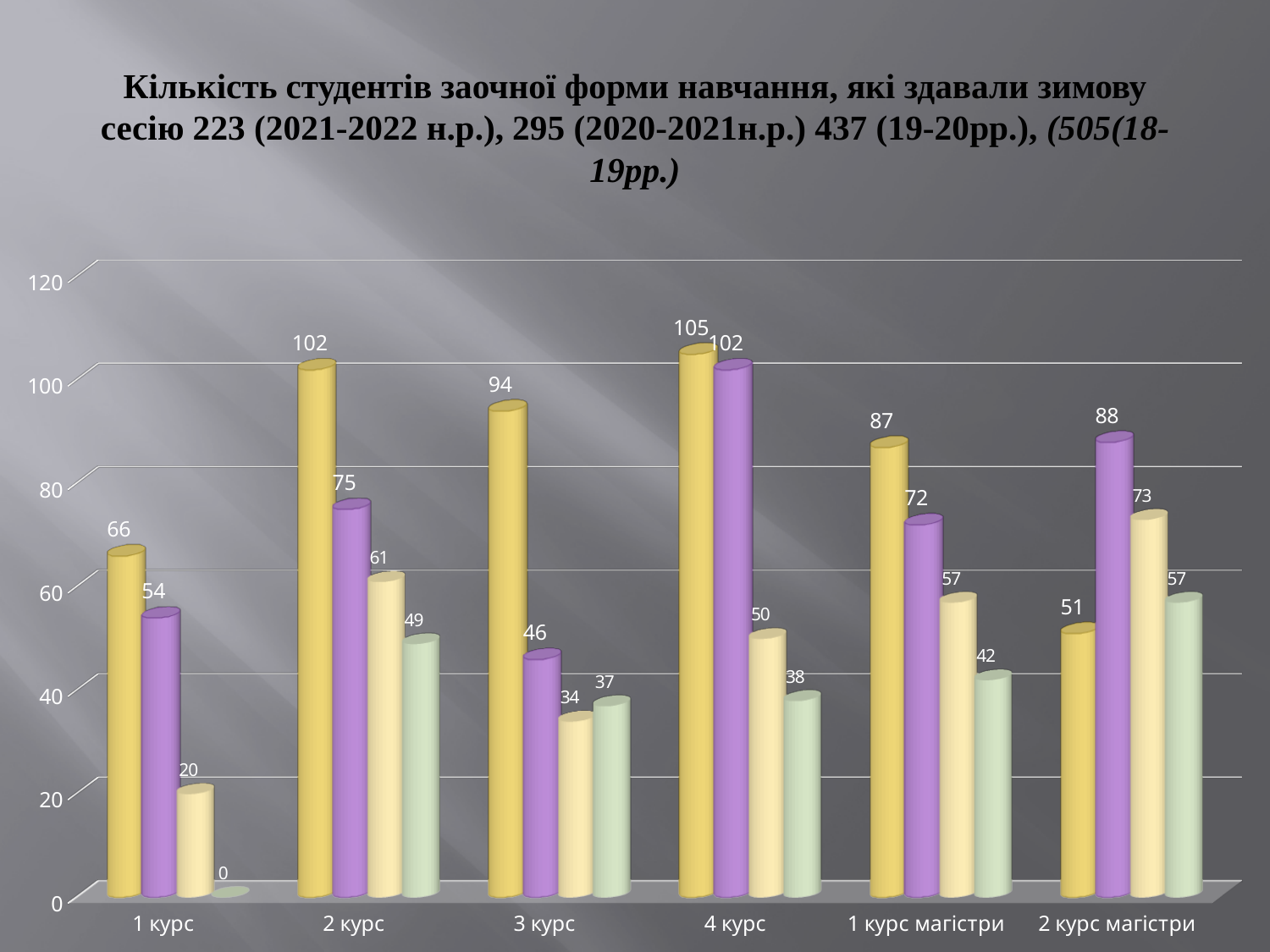
What is the difference between the gold bar and the purple bar for 2 курс? 27 What is the difference between the purple bar and the pale green bar for 1 курс магістри? 30 What is the value of the pale green (fourth) bar for 1 курс? 0 What is the value of the pale yellow (third) bar for 3 курс? 34 Which category has the highest gold (first) bar? 4 курс For 2 курс магістри, which is larger: the gold (first) bar or the purple (second) bar? the purple bar What is the value of the gold (first) bar for 4 курс? 105 What is the value of the purple (second) bar for 2 курс магістри? 88 Which category has the lowest pale yellow (third) bar? 1 курс How many categories are shown on the x axis? 6 What kind of chart is shown on the slide? bar chart Is the value of the purple (second) bar for 3 курс greater or less than 60? less